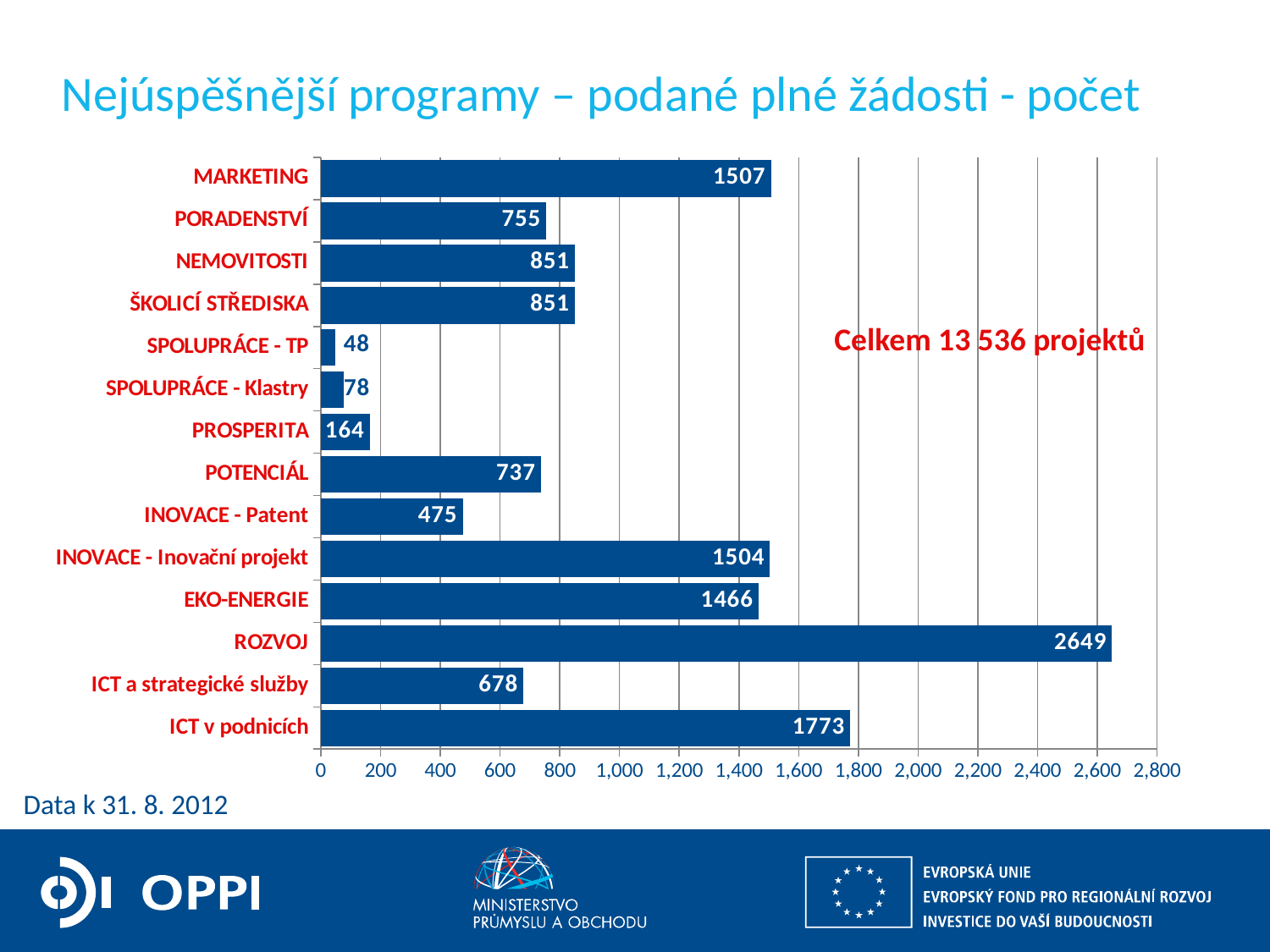
What is the value for ICT v podnicích? 1773 Which is larger, the value for MARKETING or the value for EKO-ENERGIE? MARKETING What kind of chart is shown on the slide? bar chart What is the value for SPOLUPRÁCE - Klastry? 78 What is the difference between the values for PORADENSTVÍ and NEMOVITOSTI? 96 What is the value for ROZVOJ? 2649 Which category has the lowest value? SPOLUPRÁCE - TP How many categories are shown in the chart? 14 Is the value for POTENCIÁL greater or less than 800? less Which category has the highest value? ROZVOJ What total number of projects is stated on the chart? 13 536 What is the difference between the values for ROZVOJ and ICT v podnicích? 876